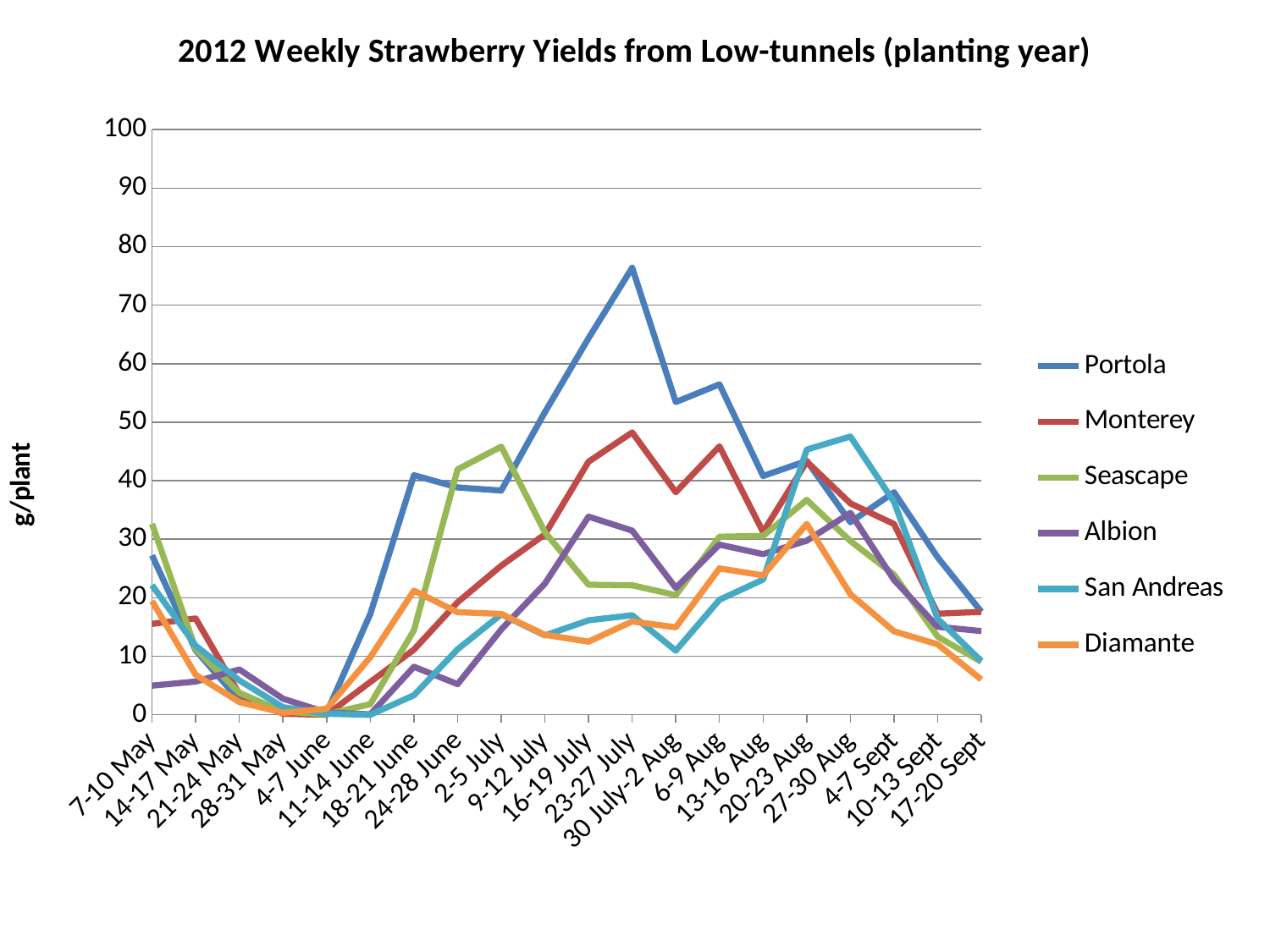
What kind of chart is shown on the slide? line chart How many series does the legend list? 6 What is the label on the y axis? g/plant Is the value for Portola in the week of 23-27 July greater or less than 70? greater In the week of 2-5 July, which has the higher yield, Seascape or Portola? Seascape Is the value for Seascape in the week of 2-5 July greater or less than 40? greater In the week of 27-30 Aug, which has the higher yield, San Andreas or Diamante? San Andreas Which series reaches the highest yield at any point in the chart? Portola How many weekly periods are shown along the x axis? 20 In which week does Portola reach its highest yield? 23-27 July Does the Portola yield rise or fall overall from 23-27 July to 17-20 Sept? fall Is the value for Diamante in the week of 17-20 Sept greater or less than 10? less